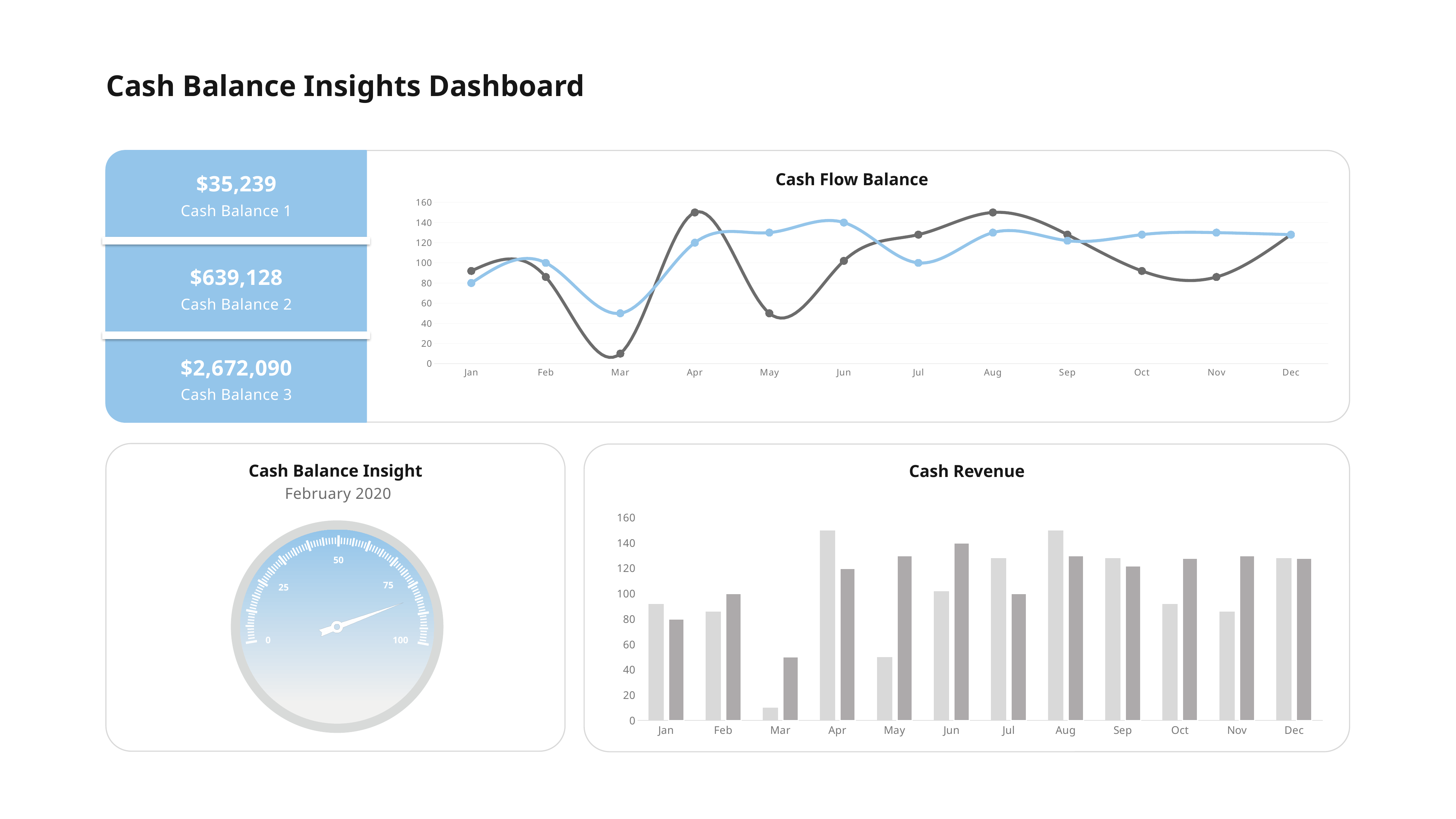
What kind of chart is the Cash Flow Balance chart? line chart What kind of chart is the Cash Revenue chart? bar chart In the Cash Revenue chart, which month has the lowest light grey bar? Mar In the Cash Flow Balance chart, which is larger in May: the blue line or the dark grey line? the blue line In the Cash Revenue chart, is the dark grey bar for Mar greater or less than 60? less In the Cash Flow Balance chart, which month has the lowest value on the blue line? Mar In the Cash Flow Balance chart, is the dark grey line's value for Apr greater or less than 140? greater In the Cash Flow Balance chart, which month has the lowest value on the dark grey line? Mar In the Cash Revenue chart, which month has the highest dark grey bar? Jun How many months are shown on the x axis of the Cash Revenue chart? 12 In the Cash Flow Balance chart, is the blue line's value for Mar greater or less than 60? less In the Cash Revenue chart, which is larger in Apr: the light grey bar or the dark grey bar? the light grey bar